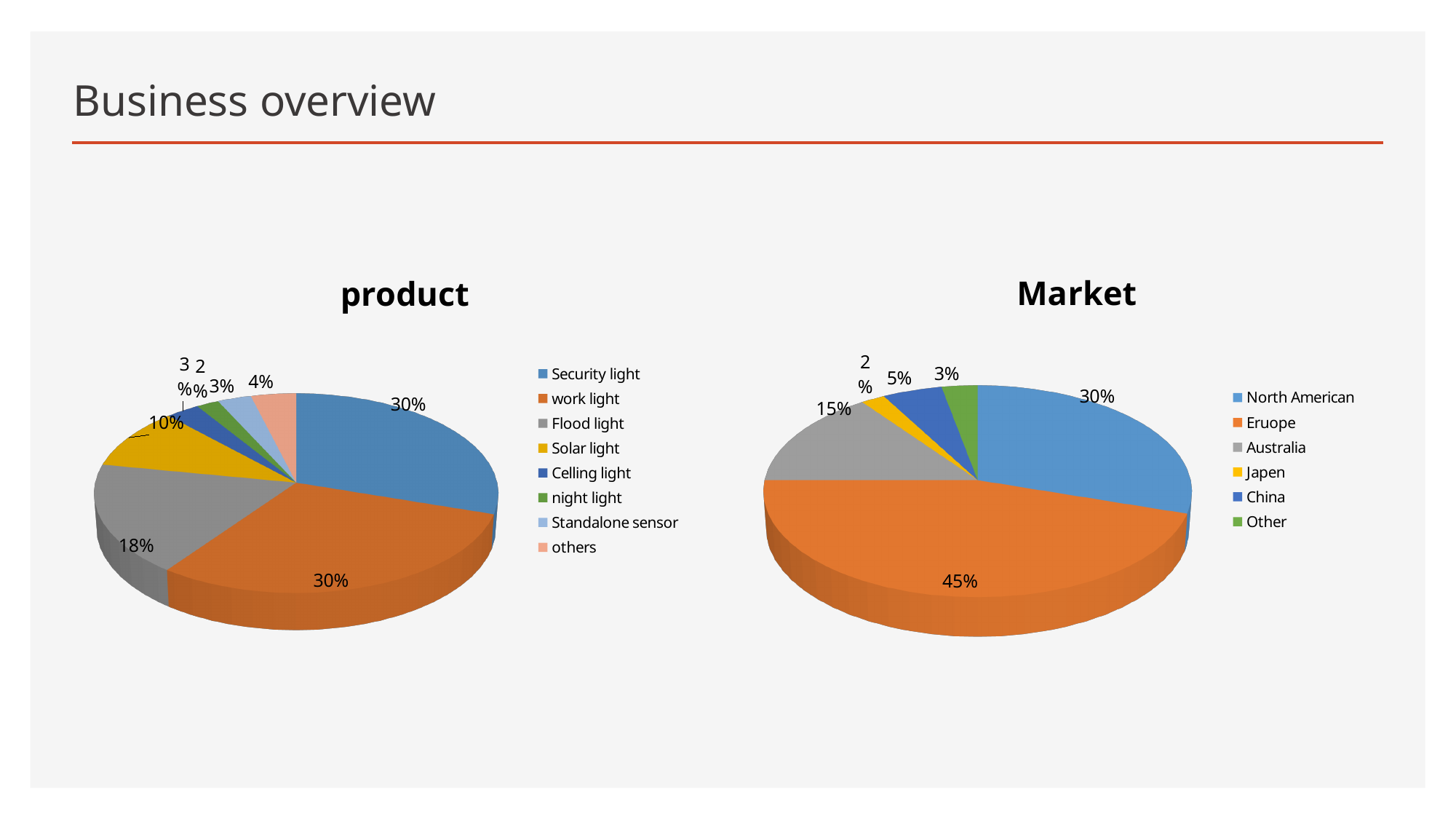
In the product chart, what share does Solar light have? 10% In the Market chart, which region has the largest share? Eruope In the product chart, which is larger, the share of Flood light or the share of Solar light? Flood light In the Market chart, which region has the smallest share? Japen What kind of chart is the Market chart? Pie chart In the product chart, what share does Flood light have? 18% In the product chart, which product has the smallest share? night light In the Market chart, what is the difference between the shares of Eruope and North American? 15% How many categories does the legend of the product chart list? 8 In the Market chart, what share does Australia have? 15% How many categories does the legend of the Market chart list? 6 In the Market chart, what share does Eruope have? 45%